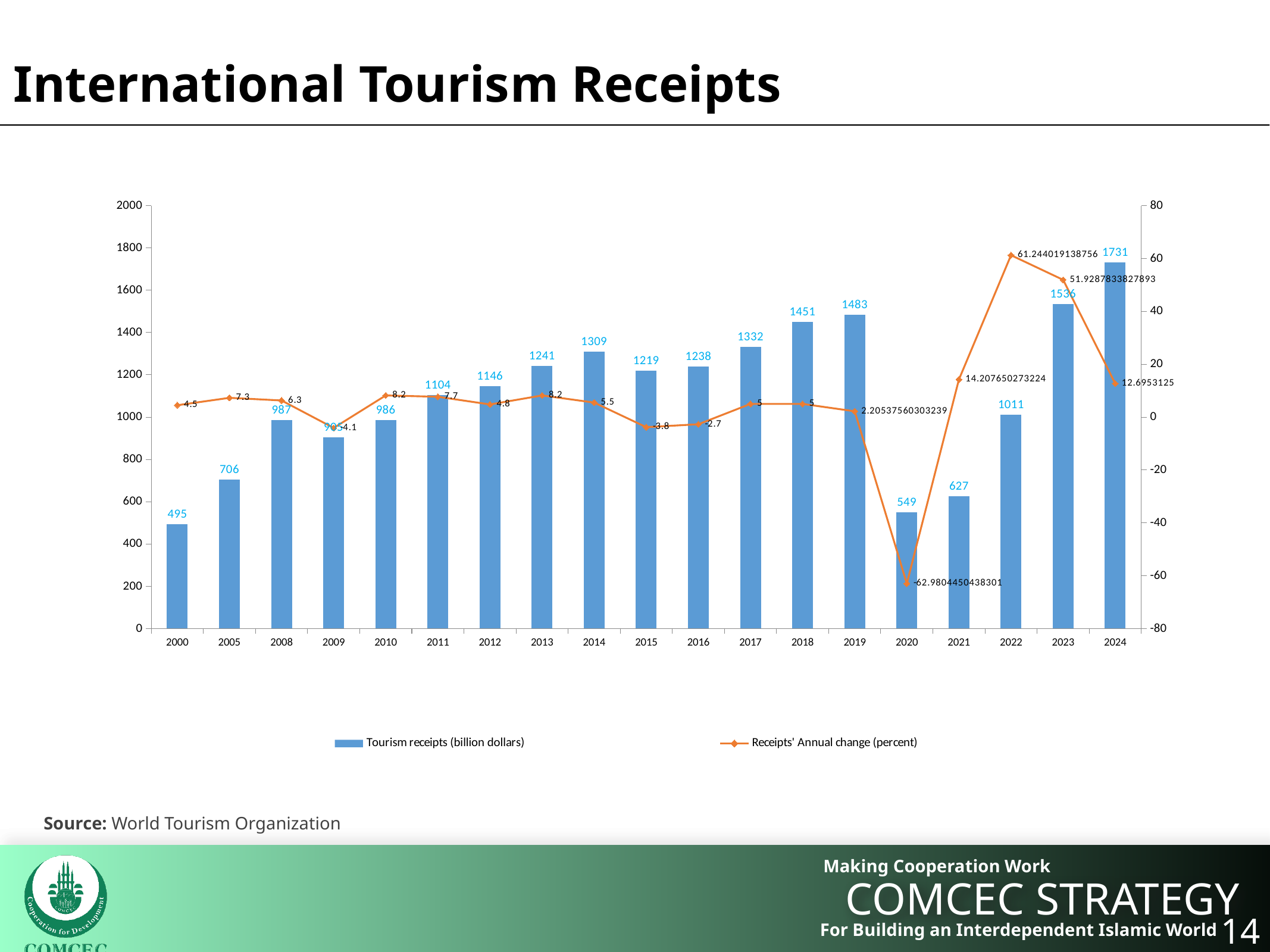
Which year has the lowest Tourism receipts (billion dollars)? 2000 Which year has the lowest Receipts' Annual change (percent)? 2020 What is the value of Tourism receipts (billion dollars) for 2020? 549 How many years are shown on the x axis of the chart? 19 How many series does the legend list? 2 Which year has higher Tourism receipts (billion dollars), 2019 or 2022? 2019 What is the Receipts' Annual change (percent) for 2010? 8.2 What is the Receipts' Annual change (percent) for 2015? -3.8 What kind of chart is shown on the slide? Combined bar and line chart What is the difference in Tourism receipts (billion dollars) between 2024 and 2023? 195 Which year has the highest Tourism receipts (billion dollars)? 2024 What is the value of Tourism receipts (billion dollars) for 2024? 1731